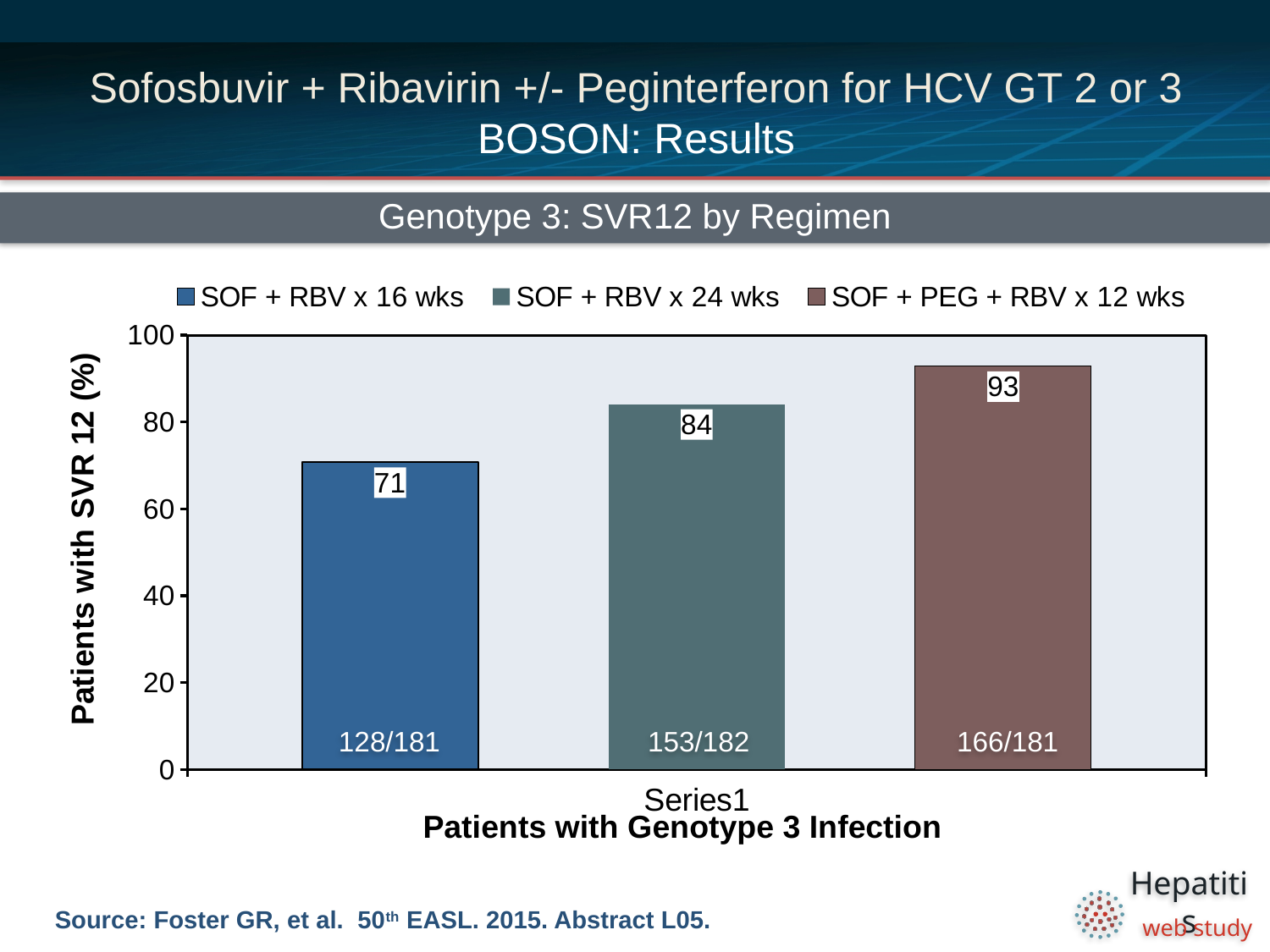
Which regimen has the highest SVR12 rate? SOF + PEG + RBV x 12 wks What kind of chart is shown on the slide? Bar chart What is the SVR12 rate for SOF + PEG + RBV x 12 wks? 93 What is the SVR12 rate for SOF + RBV x 16 wks? 71 What is the difference in SVR12 rate between SOF + PEG + RBV x 12 wks and SOF + RBV x 16 wks? 22 What is the difference in SVR12 rate between SOF + RBV x 24 wks and SOF + RBV x 16 wks? 13 What is the title of the chart? Genotype 3: SVR12 by Regimen Which regimen has the lowest SVR12 rate? SOF + RBV x 16 wks What is the SVR12 rate for SOF + RBV x 24 wks? 84 How many series does the legend list? 3 What is the patient fraction shown for the SOF + RBV x 24 wks bar? 153/182 Which has a higher SVR12 rate, SOF + RBV x 24 wks or SOF + RBV x 16 wks? SOF + RBV x 24 wks